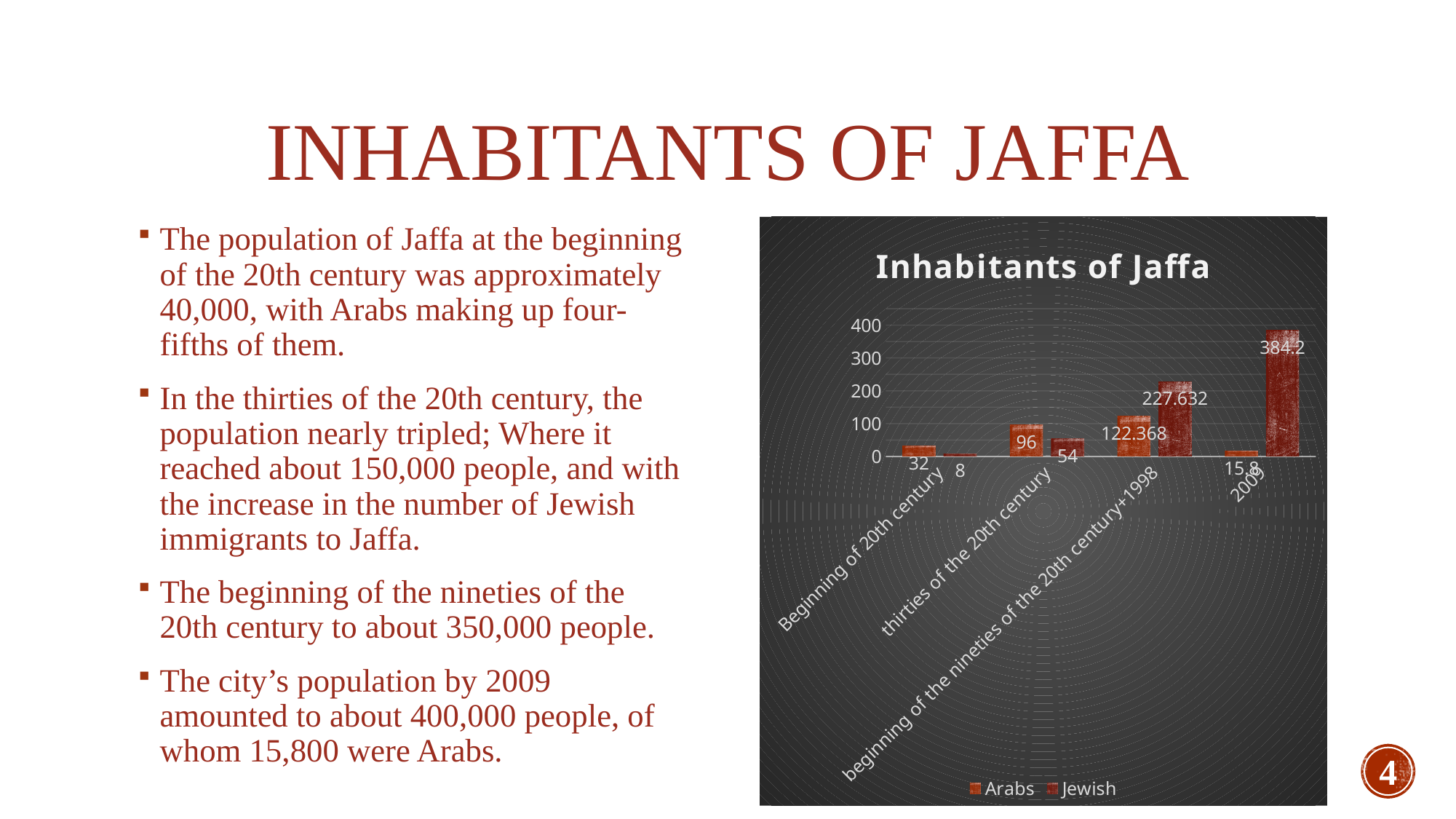
What is the difference between the Arabs value and the Jewish value in the thirties of the 20th century? 42 What is the value for Jewish in the thirties of the 20th century? 54 What is the title of the chart? Inhabitants of Jaffa How many categories are shown on the x axis of the chart? 4 What is the value for Arabs at the beginning of the 20th century? 32 Which is larger at the beginning of the nineties of the 20th century+1998, the Arabs value or the Jewish value? Jewish Which category has the lowest Arabs value? 2009 Which category has the highest Jewish value? 2009 How many series does the chart legend list? 2 What type of chart is shown on the slide? bar chart What is the value for Jewish in 2009? 384.2 What is the value for Arabs in 2009? 15.8